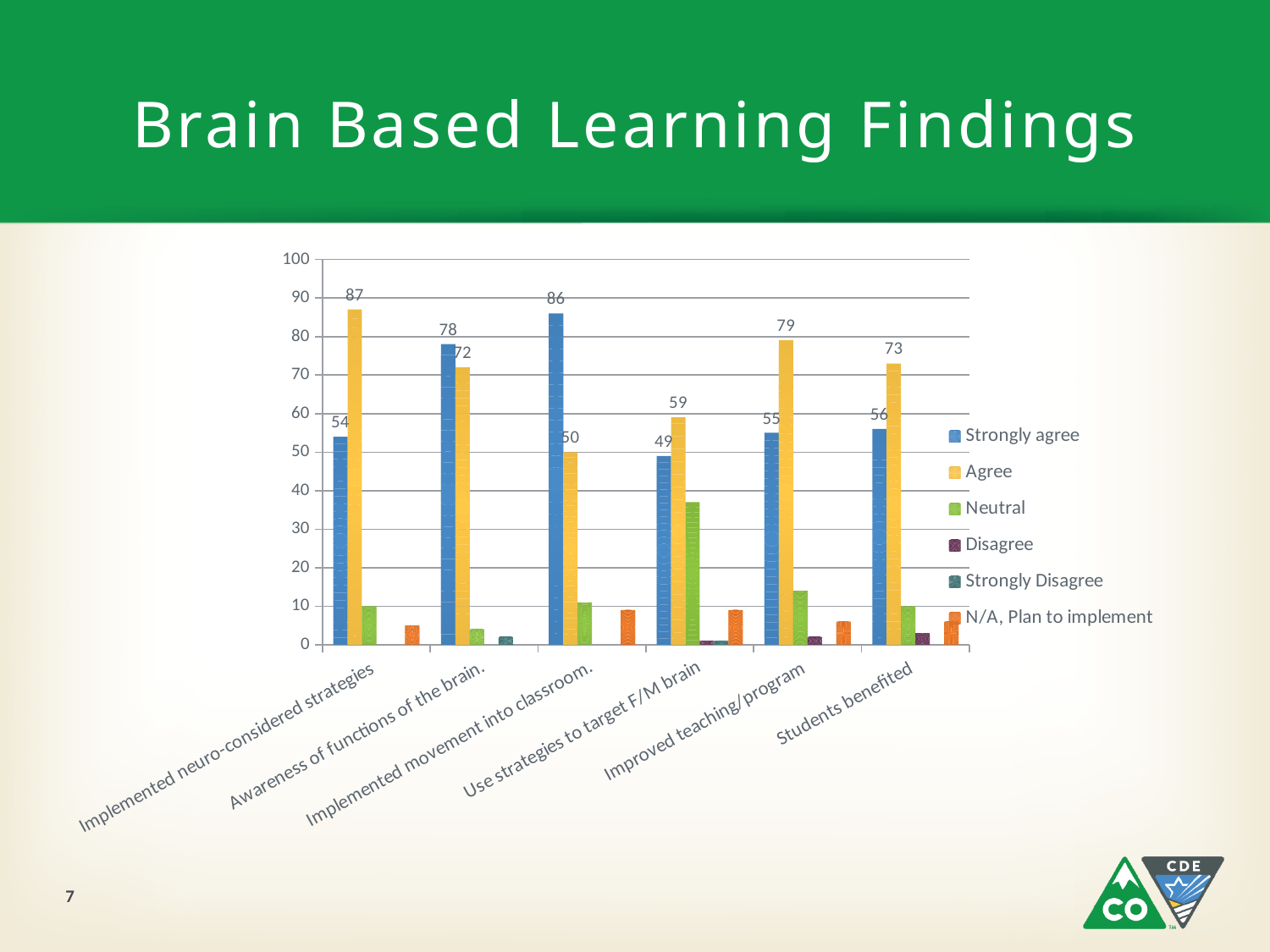
What is the difference between the Agree and Strongly agree values for "Improved teaching/program"? 24 How many categories are shown on the x axis? 6 Which category has the lowest Agree value? Implemented movement into classroom. For "Awareness of functions of the brain.", which is larger, Strongly agree or Agree? Strongly agree What is the Strongly agree value for "Implemented movement into classroom."? 86 What is the Agree value for "Use strategies to target F/M brain"? 59 What kind of chart is shown on the slide? Bar chart What is the Agree value for "Implemented neuro-considered strategies"? 87 Which category has the highest Strongly agree value? Implemented movement into classroom. What is the title of the slide containing the chart? Brain Based Learning Findings How many series does the legend list? 6 Is the Neutral value for "Use strategies to target F/M brain" greater or less than 30? greater